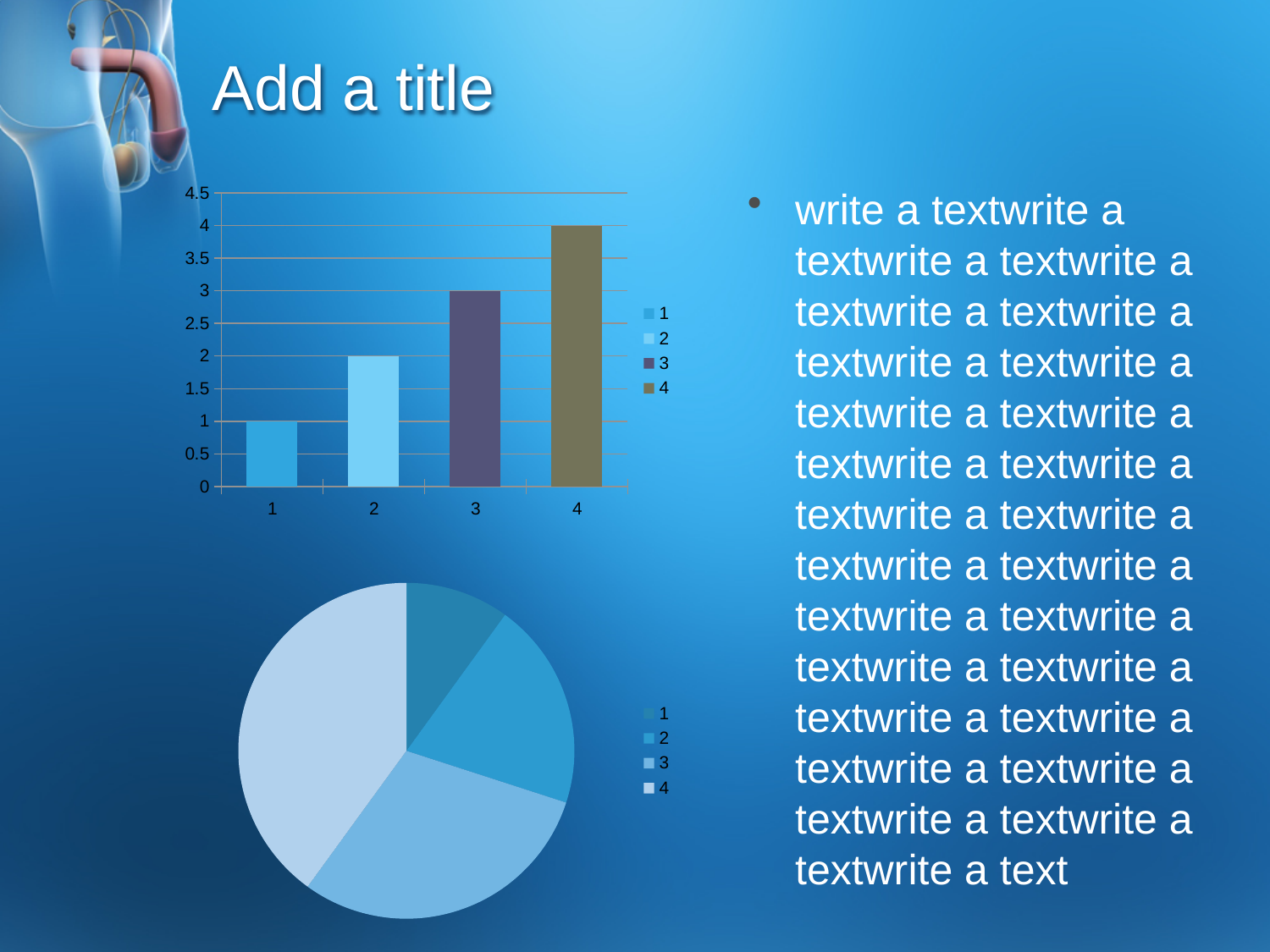
How many slices does the bottom pie chart have? 4 How many bars are in the top bar chart? 4 What type of chart is the top chart on the slide? bar chart In the top bar chart, what is the value for category 1? 1 In the top bar chart, do the values rise or fall from category 1 to category 4? rise What type of chart is the bottom chart on the slide? pie chart How many entries does the legend of the bottom pie chart list? 4 In the top bar chart, which category has the lowest value? 1 In the top bar chart, what is the difference between the values for category 4 and category 2? 2 In the top bar chart, which category has the highest value? 4 In the top bar chart, what is the value for category 3? 3 In the top bar chart, which is larger, the value for category 2 or the value for category 3? category 3